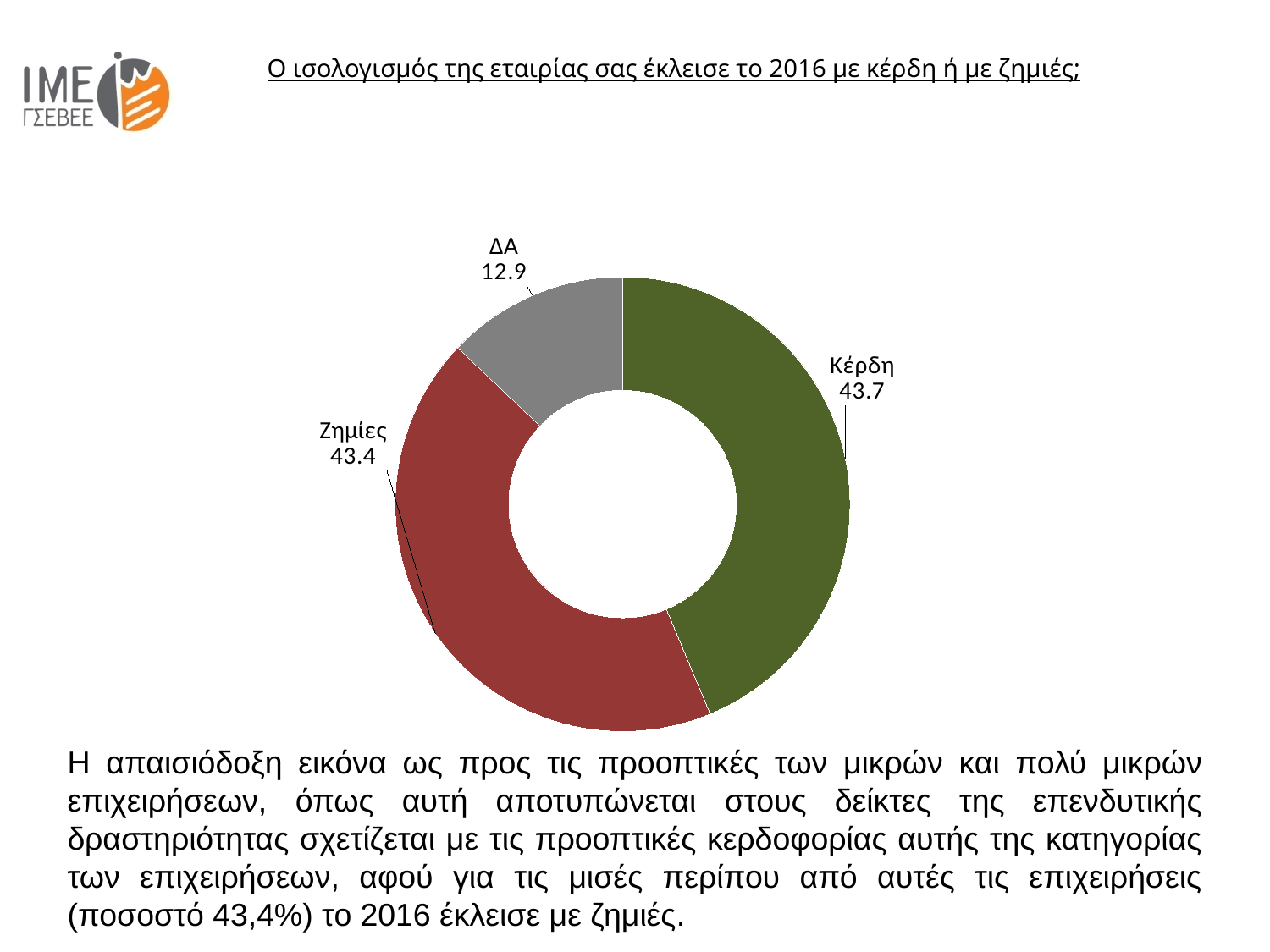
What is the value shown for ΔΑ in the chart? 12.9 What is the value shown for Ζημίες in the chart? 43.4 Which is larger, the slice for Ζημίες or the slice for ΔΑ? Ζημίες What colour is the slice for Ζημίες? red What is the title of the chart on the slide? Ο ισολογισμός της εταιρίας σας έκλεισε το 2016 με κέρδη ή με ζημιές; What is the difference between the values for Κέρδη and ΔΑ? 30.8 What is the value shown for Κέρδη in the chart? 43.7 How many categories are shown in the chart? 3 What is the difference between the values for Ζημίες and ΔΑ? 30.5 Which is larger, the slice for Κέρδη or the slice for ΔΑ? Κέρδη Which category has the smallest slice in the chart? ΔΑ What kind of chart is shown on the slide? doughnut chart